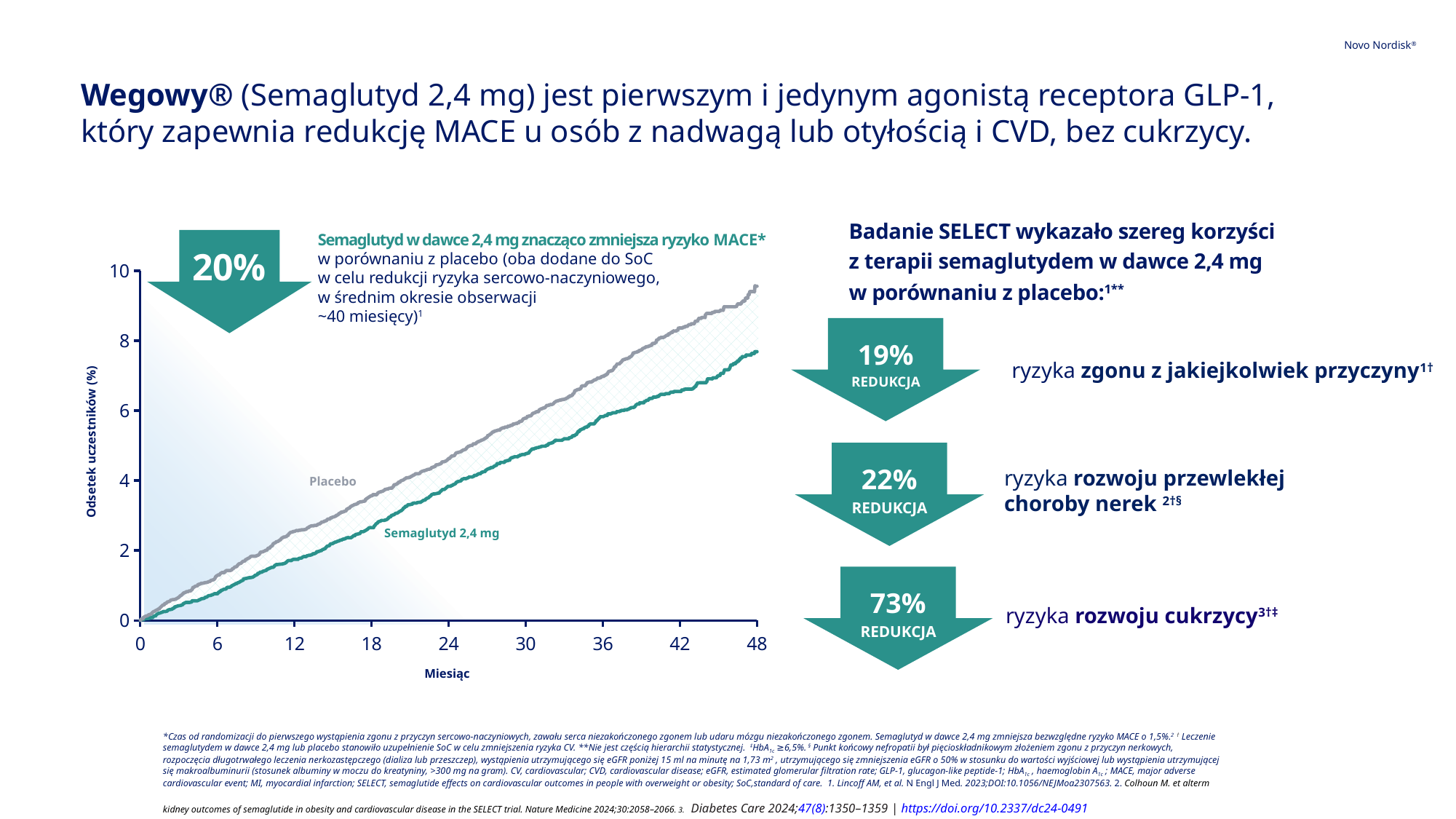
Is the value for Semaglutyd 2,4 mg at month 48 greater or less than 8? less What is the label of the y axis of the chart? Odsetek uczestników (%) How many series are plotted on the chart? 2 What is the highest value shown on the x axis of the chart? 48 Is the value for Placebo at month 36 greater or less than 6? greater Do the plotted values rise or fall as the months increase along the x axis? rise Is the value for Placebo at month 48 greater or less than 8? greater Which series has the higher value at month 48, Placebo or Semaglutyd 2,4 mg? Placebo What kind of chart is shown on the slide? line chart